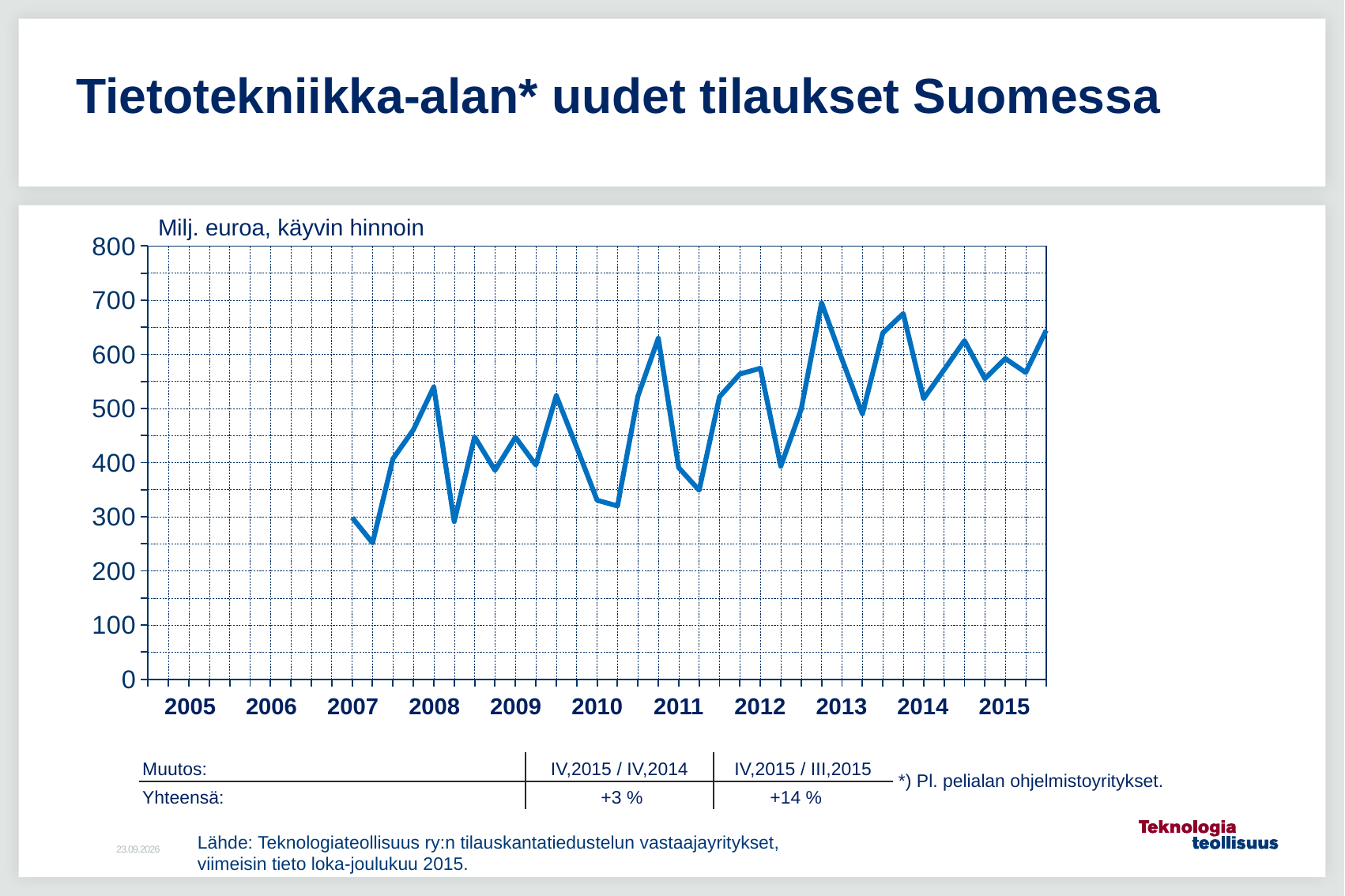
What kind of chart is shown on the slide? line chart In which year does the line reach its highest point? 2013 Overall, do the values rise or fall from 2007 to 2015? rise What unit label is shown above the vertical axis of the chart? Milj. euroa, käyvin hinnoin Is the highest point of the line greater or less than 600? greater In which year does the line reach its lowest point? 2007 How many lines are plotted on the chart? 1 Is the last plotted value (end of 2015) greater or less than 600? greater Is the lowest point of the line greater or less than 300? less What is the title of the chart on the slide? Tietotekniikka-alan* uudet tilaukset Suomessa What is the highest value shown on the vertical axis? 800